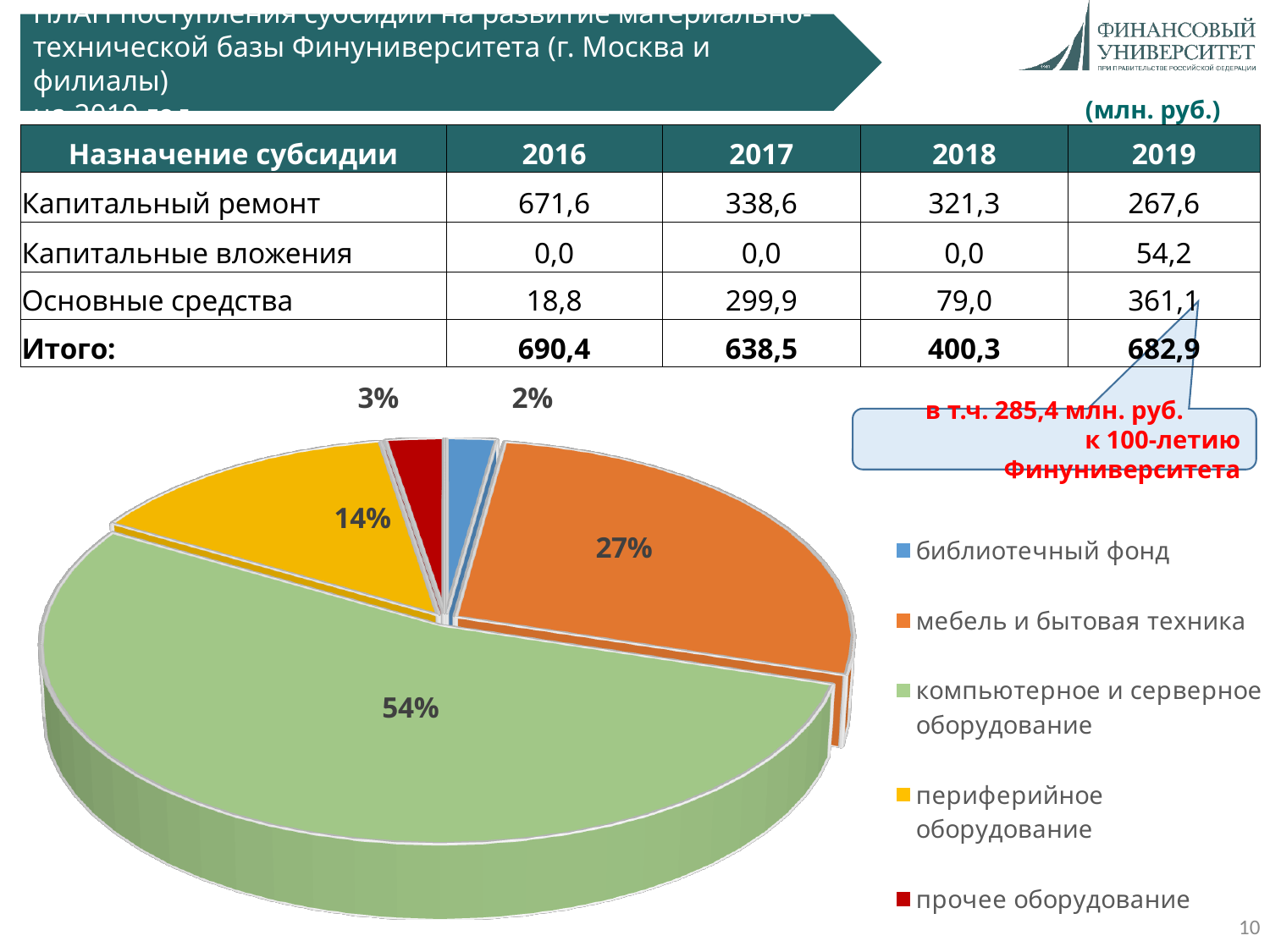
What share of the pie does библиотечный фонд have? 2% What kind of chart is shown on the slide? pie chart Which category has the largest slice of the pie chart? компьютерное и серверное оборудование What share of the pie does компьютерное и серверное оборудование have? 54% What share of the pie does мебель и бытовая техника have? 27% How many slices does the pie chart have? 5 How many entries does the pie chart legend list? 5 What is the difference in percentage points between the shares of компьютерное и серверное оборудование and мебель и бытовая техника? 27% Which colour represents периферийное оборудование in the pie chart? yellow Which category has the smallest slice of the pie chart? библиотечный фонд